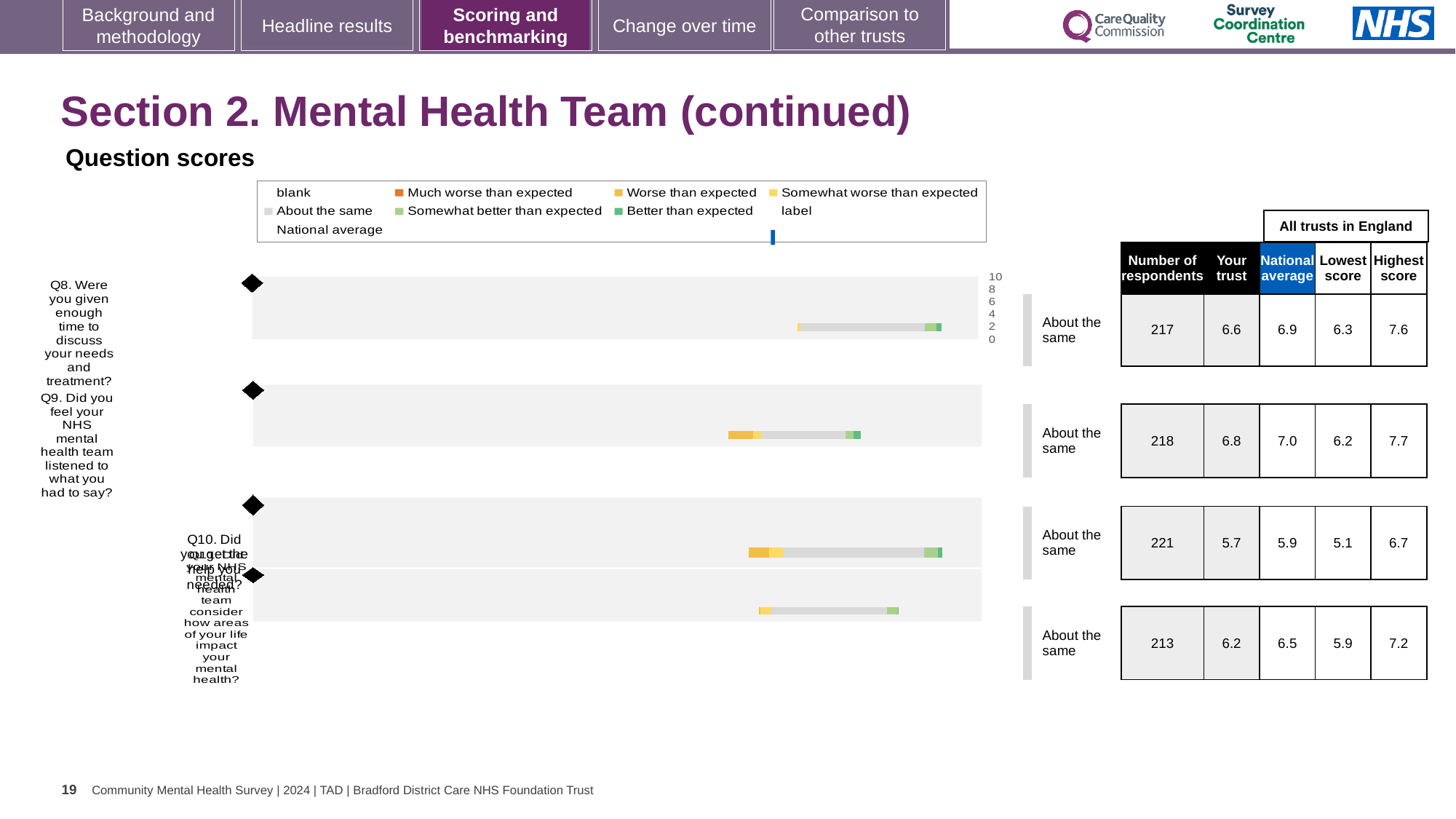
For Q8, which is larger: the 'Your trust' score or the national average? National average Which legend entry in the question scores chart is shown in orange? Much worse than expected What is the highest score across all trusts in England for the last question (Q11) in the chart? 7.2 Which question has the highest 'Your trust' score? Q9 Which question has the lowest 'Your trust' score? Q10 What benchmark category is shown for Q9 in the question scores chart? About the same What is the national average score for Q9 (Did you feel your NHS mental health team listened to what you had to say?)? 7.0 What is the 'Your trust' score for Q10 (Did you get the help you needed?)? 5.7 For Q8, what is the difference between the highest score and the lowest score across all trusts in England? 1.3 What kind of chart is used to show the question scores on this slide? bar chart What is the number of respondents for Q8 (Were you given enough time to discuss your needs and treatment?)? 217 How many questions (bars) are plotted in the question scores chart? 4